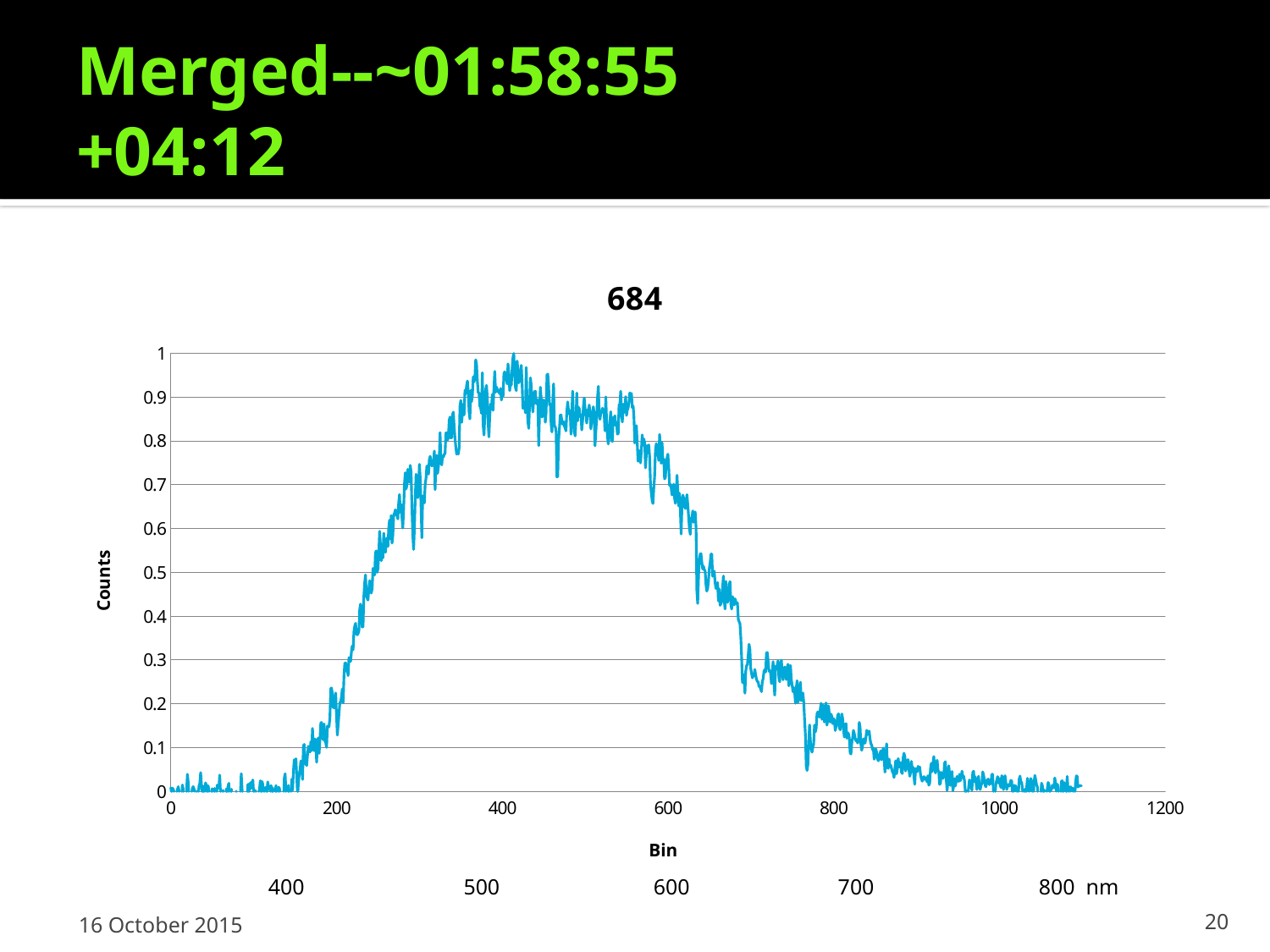
Do the values rise or fall along the x axis between bin 200 and bin 400? rise What kind of chart is shown on the slide? line chart Is the value for bin 1000 greater or less than 0.1? less Is the value for bin 600 greater or less than 0.5? greater What is the label of the y axis of the chart? Counts What is the title of the chart? 684 Is the value for bin 200 greater or less than 0.3? less Which has the larger value, bin 400 or bin 800? bin 400 Do the values rise or fall along the x axis between bin 600 and bin 1000? fall Which has the larger value, bin 600 or bin 200? bin 600